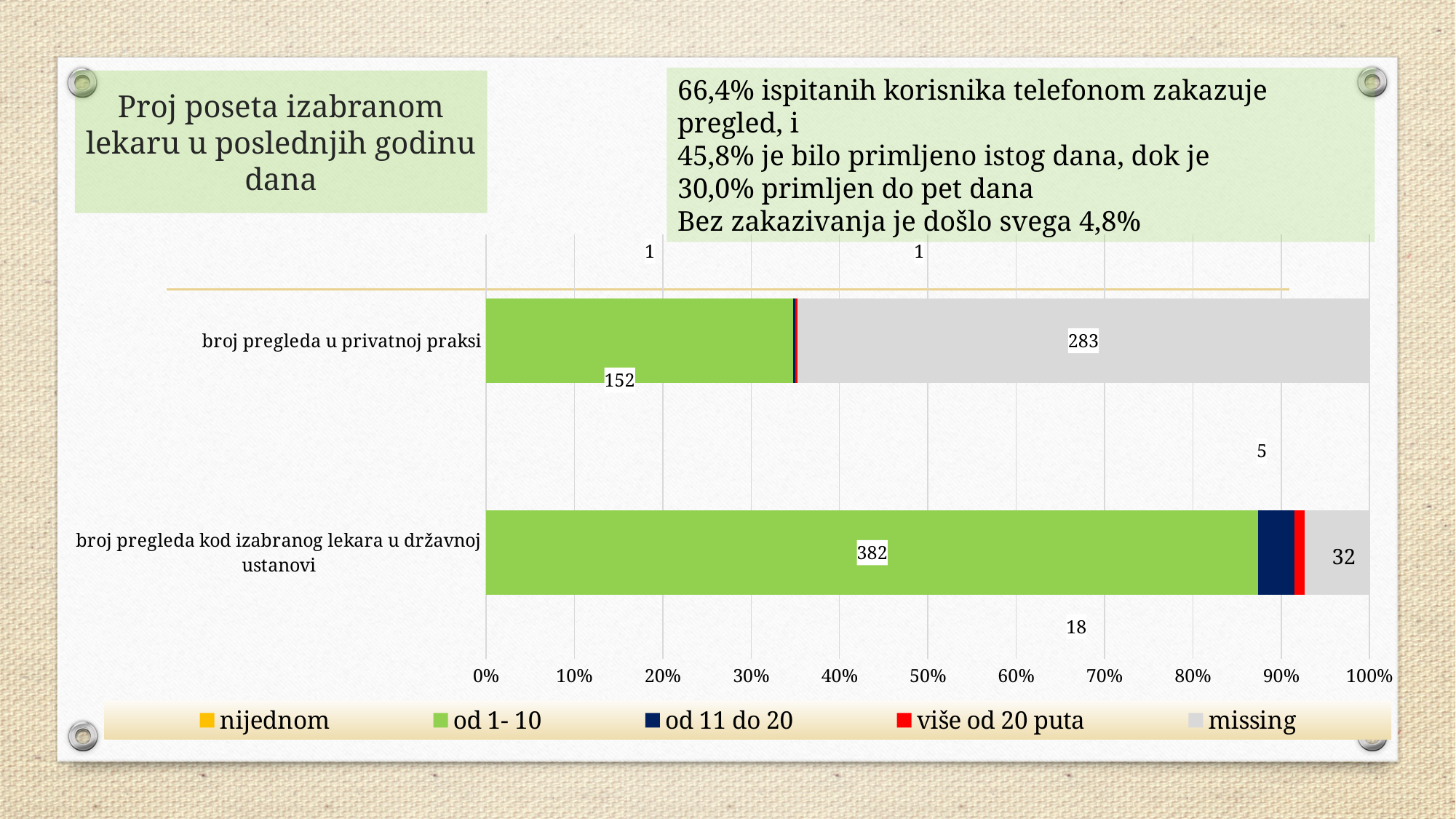
How many categories (bars) are plotted on the chart? 2 How many series does the legend list? 5 What is the value of the 'od 1- 10' segment for 'broj pregleda kod izabranog lekara u državnoj ustanovi'? 382 What is the value of the 'missing' segment for 'broj pregleda u privatnoj praksi'? 283 What is the value of the 'od 1- 10' segment for 'broj pregleda u privatnoj praksi'? 152 Which legend entry is shown in red? više od 20 puta What is the value of the 'missing' segment for 'broj pregleda kod izabranog lekara u državnoj ustanovi'? 32 What is the value of the 'od 11 do 20' segment for 'broj pregleda kod izabranog lekara u državnoj ustanovi'? 18 What is the difference between the 'od 1- 10' values for the state institution bar (382) and the private practice bar (152)? 230 Which category has the larger 'od 1- 10' value: 'broj pregleda u privatnoj praksi' or 'broj pregleda kod izabranog lekara u državnoj ustanovi'? broj pregleda kod izabranog lekara u državnoj ustanovi What is the total of all labelled segments in the 'broj pregleda kod izabranog lekara u državnoj ustanovi' bar (382, 18, 5, 32)? 437 What kind of chart is shown on the slide? bar chart